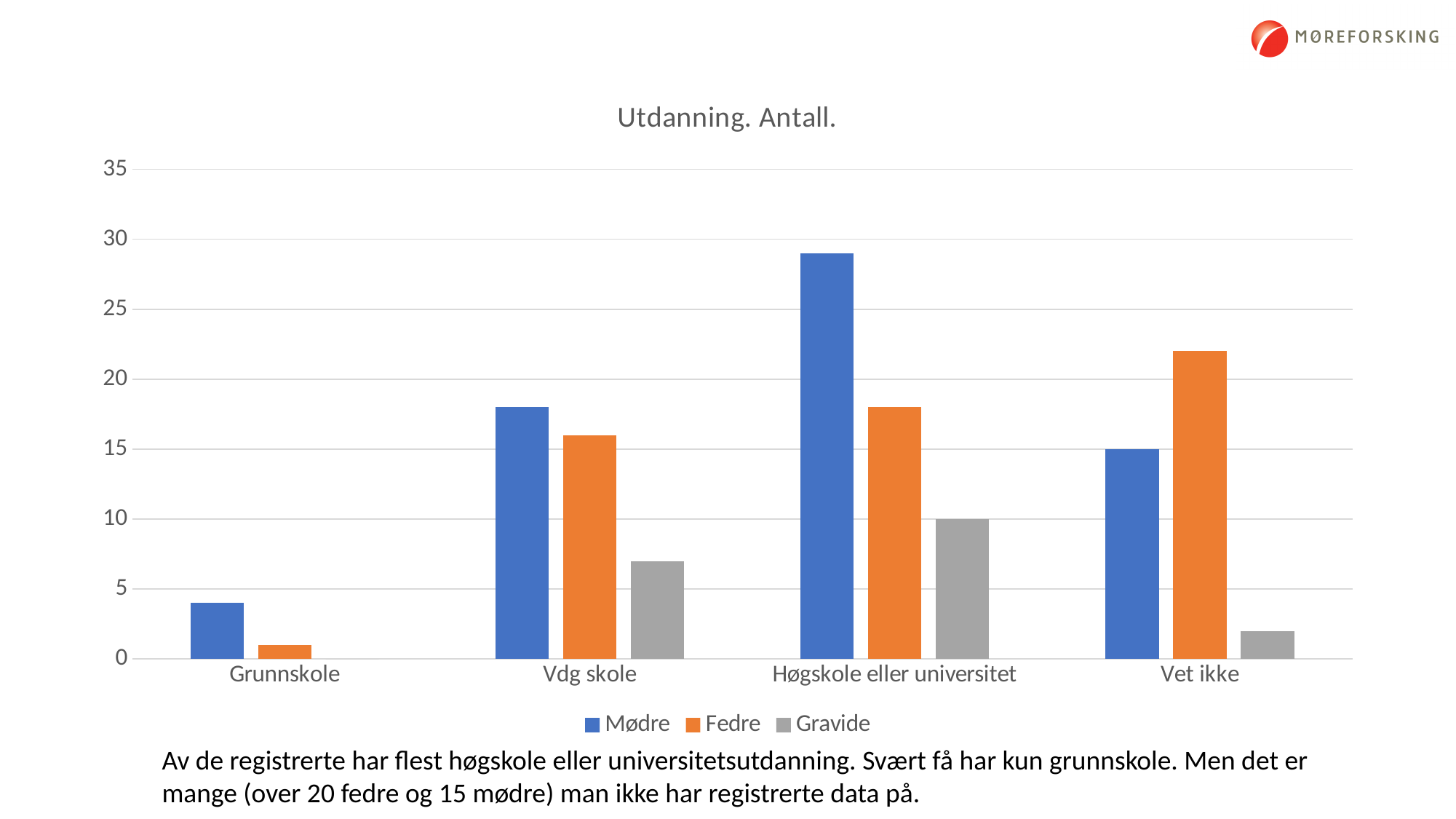
Is the value for Mødre in Høgskole eller universitet greater or less than 25? greater How many series does the legend list? 3 Which category has the highest value for Mødre? Høgskole eller universitet Which category has the highest value for Fedre? Vet ikke What is the value for Mødre in the Vet ikke category? 15 What is the title of the chart? Utdanning. Antall. Which category has the lowest value for Fedre? Grunnskole Is the value for Gravide in Vdg skole greater or less than 10? less In the Vet ikke category, which is larger, Mødre or Fedre? Fedre What kind of chart is shown on the slide? bar chart What is the value for Gravide in the Høgskole eller universitet category? 10 How many categories are shown on the x axis? 4